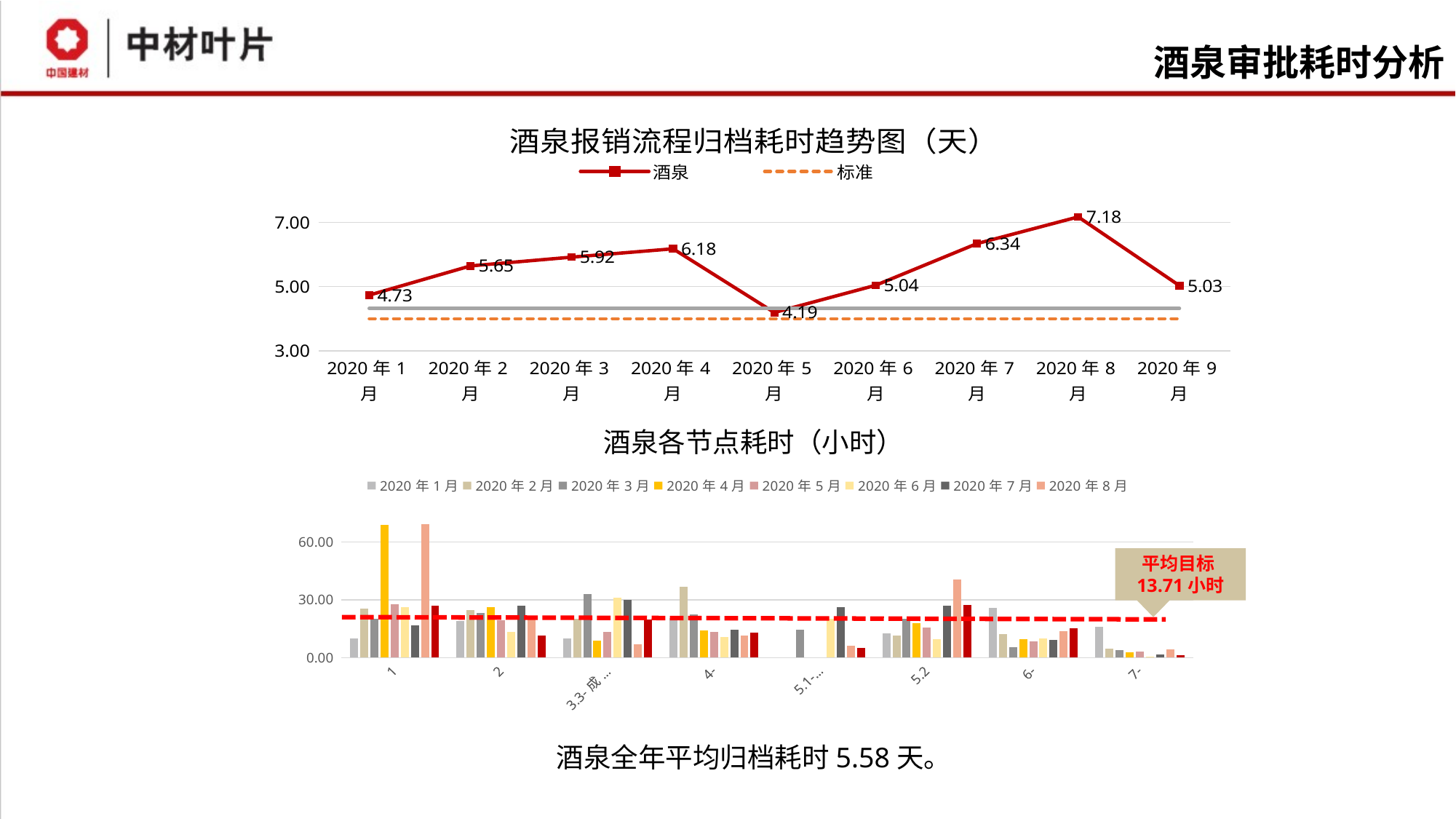
In the chart titled 酒泉报销流程归档耗时趋势图（天）, what is the value for 酒泉 in 2020年8月? 7.18 In the chart titled 酒泉报销流程归档耗时趋势图（天）, does the 酒泉 value rise or fall from 2020年1月 to 2020年4月? rise In the chart titled 酒泉报销流程归档耗时趋势图（天）, what is the value for 酒泉 in 2020年5月? 4.19 In the chart titled 酒泉报销流程归档耗时趋势图（天）, how many series does the legend list? 2 What kind of chart is the chart titled 酒泉各节点耗时（小时）? bar chart In the chart titled 酒泉报销流程归档耗时趋势图（天）, which is larger, the 酒泉 value for 2020年4月 or for 2020年7月? 2020年7月 In the chart titled 酒泉报销流程归档耗时趋势图（天）, how many months are plotted on the x axis? 9 In the chart titled 酒泉报销流程归档耗时趋势图（天）, what is the difference between the 酒泉 values for 2020年8月 and 2020年9月? 2.15 In the chart titled 酒泉报销流程归档耗时趋势图（天）, which month has the lowest value for 酒泉? 2020年5月 In the chart titled 酒泉各节点耗时（小时）, how many series does the legend list? 8 In the chart titled 酒泉报销流程归档耗时趋势图（天）, what is the value for 酒泉 in 2020年1月? 4.73 In the chart titled 酒泉报销流程归档耗时趋势图（天）, which month has the highest value for 酒泉? 2020年8月